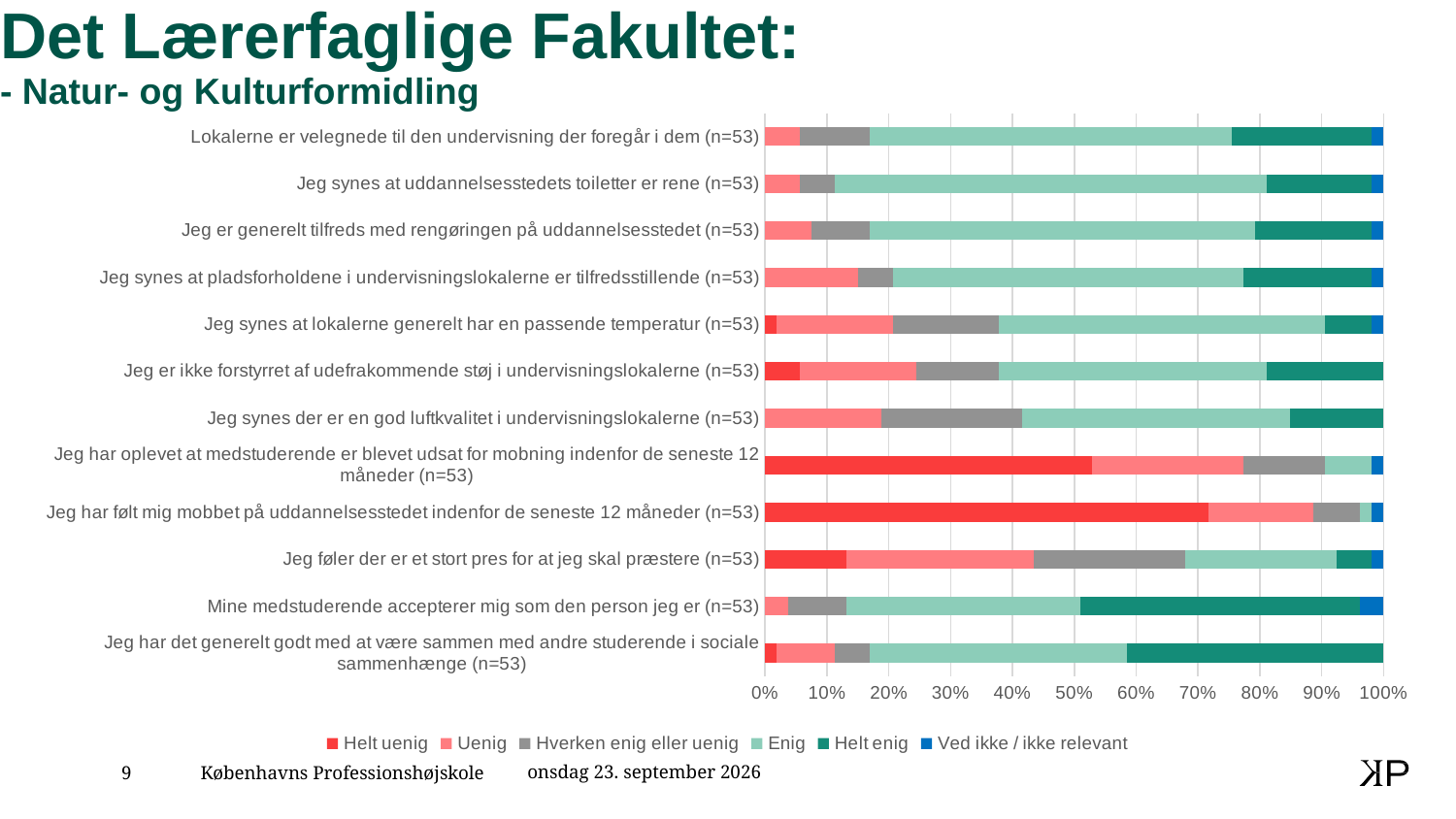
Which statement has the largest 'Helt uenig' share? Jeg har følt mig mobbet på uddannelsesstedet indenfor de seneste 12 måneder (n=53) Which has the larger 'Helt uenig' share: 'Jeg har følt mig mobbet på uddannelsesstedet indenfor de seneste 12 måneder' or 'Jeg føler der er et stort pres for at jeg skal præstere'? Jeg har følt mig mobbet på uddannelsesstedet indenfor de seneste 12 måneder Is the 'Helt uenig' share for 'Jeg har oplevet at medstuderende er blevet udsat for mobning indenfor de seneste 12 måneder' greater or less than 40%? greater Is the 'Enig' share for 'Jeg synes at uddannelsesstedets toiletter er rene' greater or less than 60%? greater Is the 'Helt enig' share for 'Mine medstuderende accepterer mig som den person jeg er' greater or less than 50%? less How many series does the legend list? 6 What kind of chart is shown on the slide? Stacked bar chart Which response category does the legend list first? Helt uenig How many statements (categories) are plotted in the chart? 12 What is the sample size (n) shown for each statement in the chart? 53